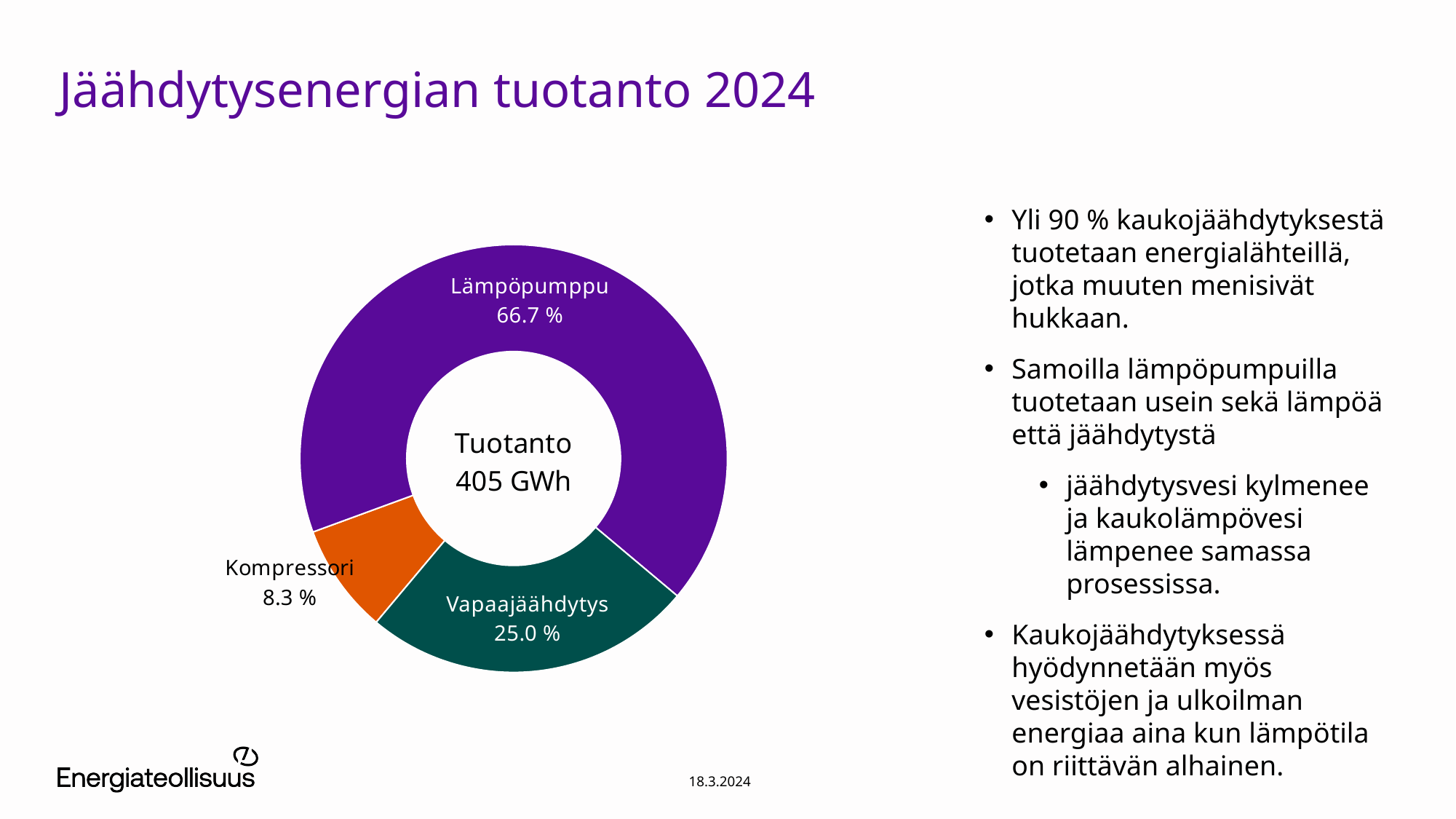
Which has a larger share, Vapaajäähdytys or Kompressori? Vapaajäähdytys Which category has the largest share of the chart? Lämpöpumppu What share of the chart does Vapaajäähdytys account for? 25.0 % What is the title of the slide containing the chart? Jäähdytysenergian tuotanto 2024 What kind of chart is shown on the slide? Doughnut (pie) chart What share of the chart does Kompressori account for? 8.3 % How many categories are shown in the chart? 3 Which category has the smallest share of the chart? Kompressori What share of the chart does Lämpöpumppu account for? 66.7 % What is the difference in percentage points between the Lämpöpumppu and Vapaajäähdytys shares? 41.7 What colour is the Vapaajäähdytys segment of the chart? Dark green What total production value is shown in the centre of the chart? 405 GWh